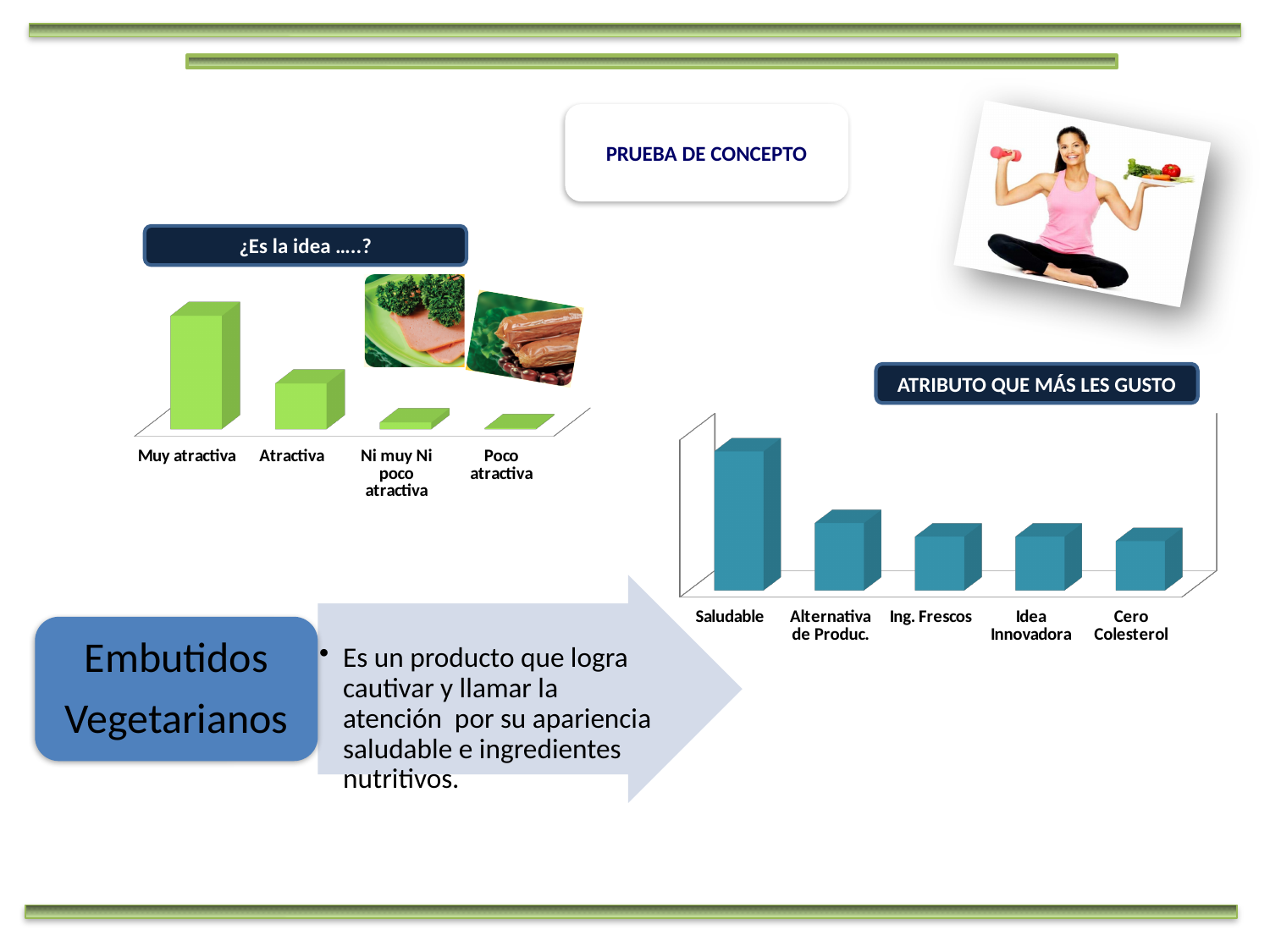
What kind of chart is the one titled 'ATRIBUTO QUE MÁS LES GUSTO'? bar chart In the chart titled '¿Es la idea …..?', which category has the lowest bar? Poco atractiva In the chart titled 'ATRIBUTO QUE MÁS LES GUSTO', which is larger: the bar for Alternativa de Produc. or the bar for Cero Colesterol? Alternativa de Produc. What colour are the bars in the chart titled 'ATRIBUTO QUE MÁS LES GUSTO'? teal blue In the chart titled '¿Es la idea …..?', do the bars rise or fall from left to right? fall In the chart titled 'ATRIBUTO QUE MÁS LES GUSTO', which is larger: the bar for Saludable or the bar for Alternativa de Produc.? Saludable In the chart titled '¿Es la idea …..?', which is larger: the bar for Atractiva or the bar for Ni muy Ni poco atractiva? Atractiva In the chart titled '¿Es la idea …..?', how many categories are shown? 4 In the chart titled 'ATRIBUTO QUE MÁS LES GUSTO', how many categories are shown? 5 In the chart titled '¿Es la idea …..?', which category has the highest bar? Muy atractiva What kind of chart is the one titled '¿Es la idea …..?'? bar chart In the chart titled 'ATRIBUTO QUE MÁS LES GUSTO', which category has the highest bar? Saludable